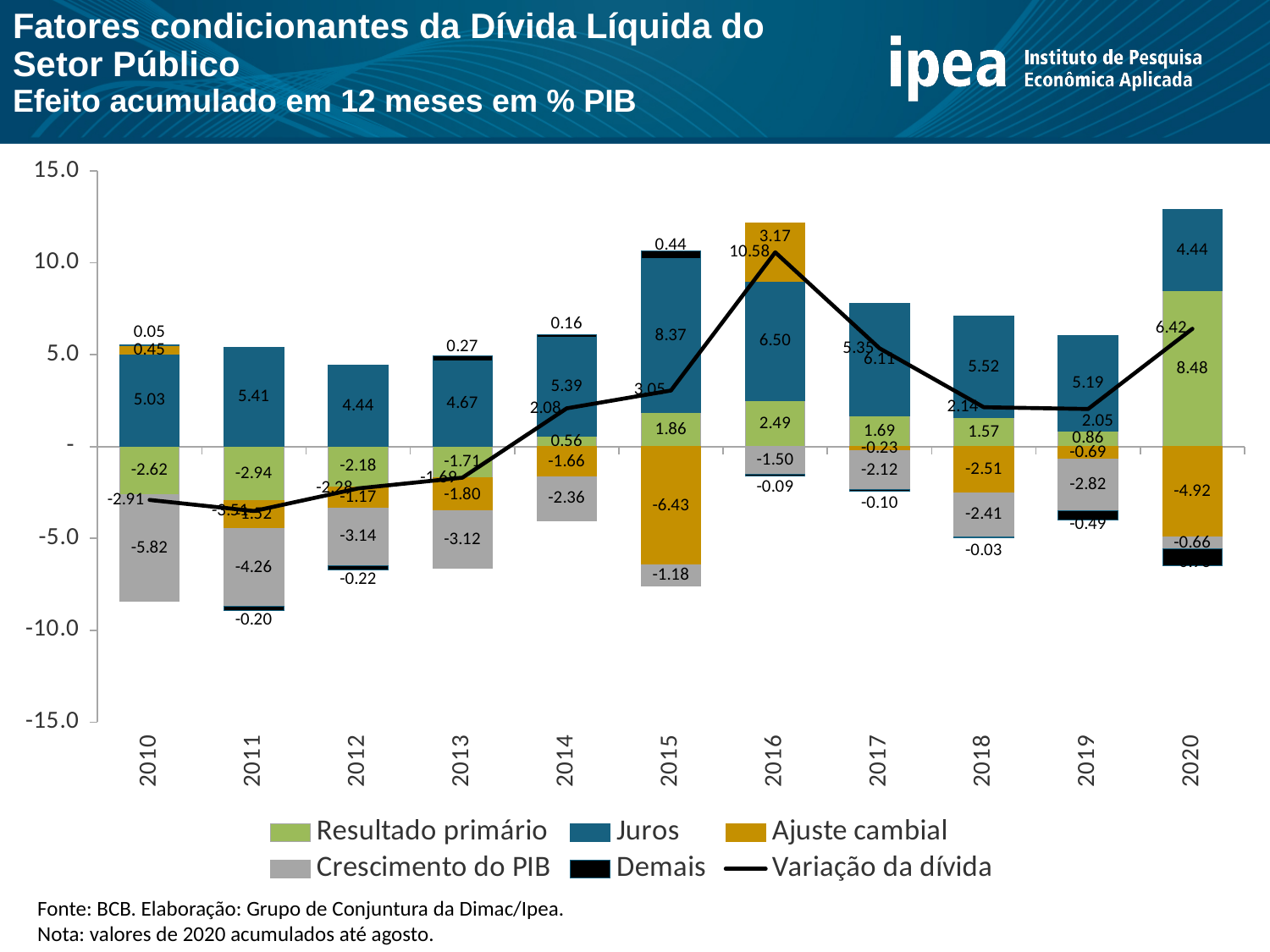
In which year is the Variação da dívida line at its highest? 2016 How many years are shown on the x axis? 11 What is the value of Crescimento do PIB for 2010? -5.82 Does the Variação da dívida line rise or fall from 2016 to 2019? fall What is the value of Ajuste cambial for 2016? 3.17 What is the value of Juros for 2015? 8.37 Which year has the larger Juros value, 2011 or 2012? 2011 What is the value of Resultado primário for 2020? 8.48 What is the difference between the Juros value in 2015 and in 2016? 1.87 In which year is the Variação da dívida line at its lowest? 2011 Is the Variação da dívida value for 2016 greater or less than 10.0? greater How many series does the legend list? 6